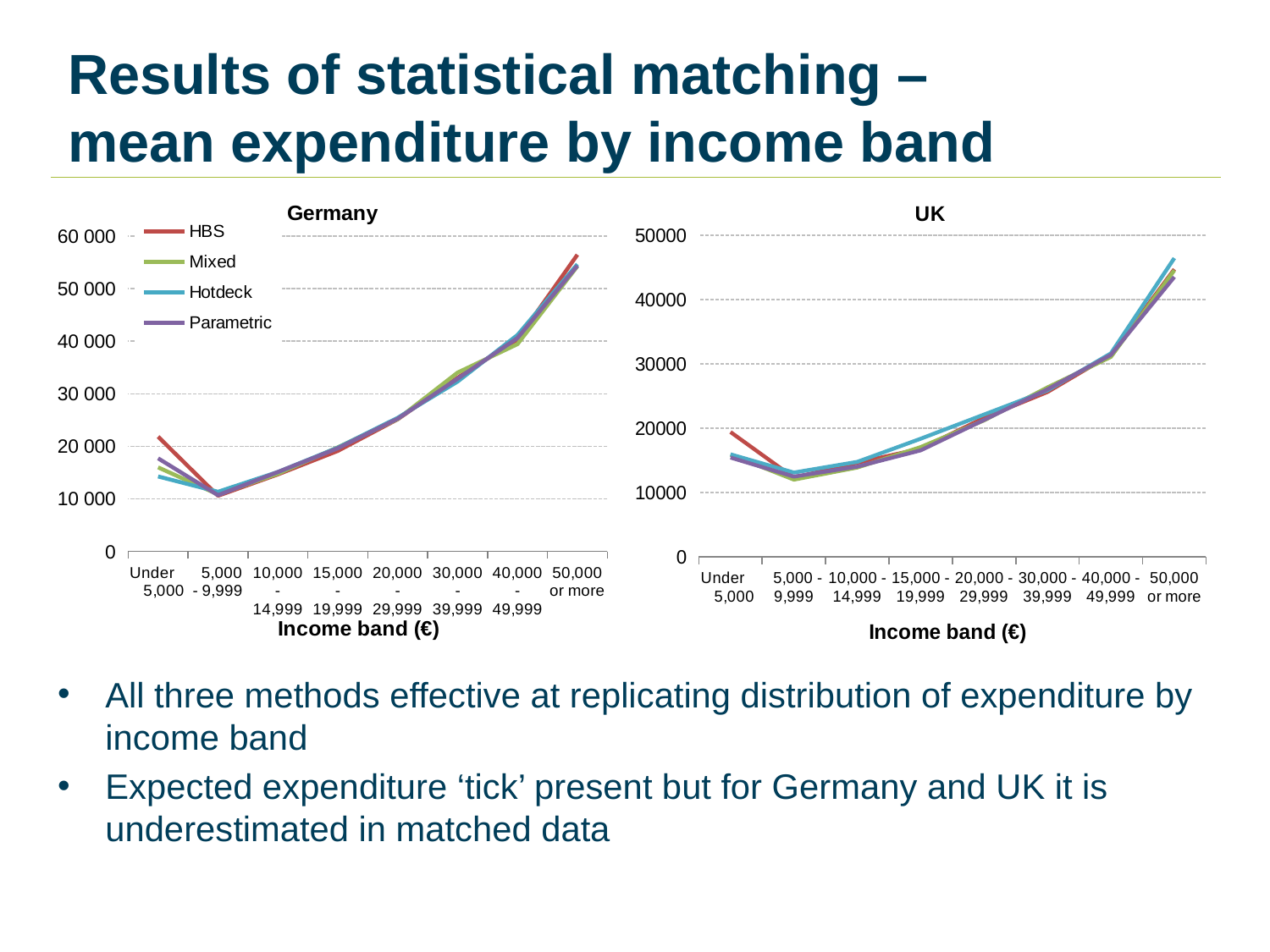
How many series does the legend on the Germany chart list? 4 What kind of chart is the Germany chart? line chart On the Germany chart, which income band has the lowest mean expenditure for the HBS series? 5,000 - 9,999 On the Germany chart, is the HBS value for the 50,000 or more band greater or less than 50 000? greater On the Germany chart, which is larger for the Under 5,000 band: the HBS value or the Hotdeck value? HBS On the Germany chart, which income band has the highest mean expenditure for the HBS series? 50,000 or more What is the x-axis label on the Germany chart? Income band (€) On the UK chart, is the HBS value for the 30,000 - 39,999 band greater or less than 30000? less On the UK chart, is the Hotdeck value for the 50,000 or more band greater or less than 40000? greater On the UK chart, do the values generally rise or fall from the 5,000 - 9,999 band to the 50,000 or more band? rise On the UK chart, which income band has the lowest value for the Mixed series? 5,000 - 9,999 How many income bands are shown on the x axis of the UK chart? 8